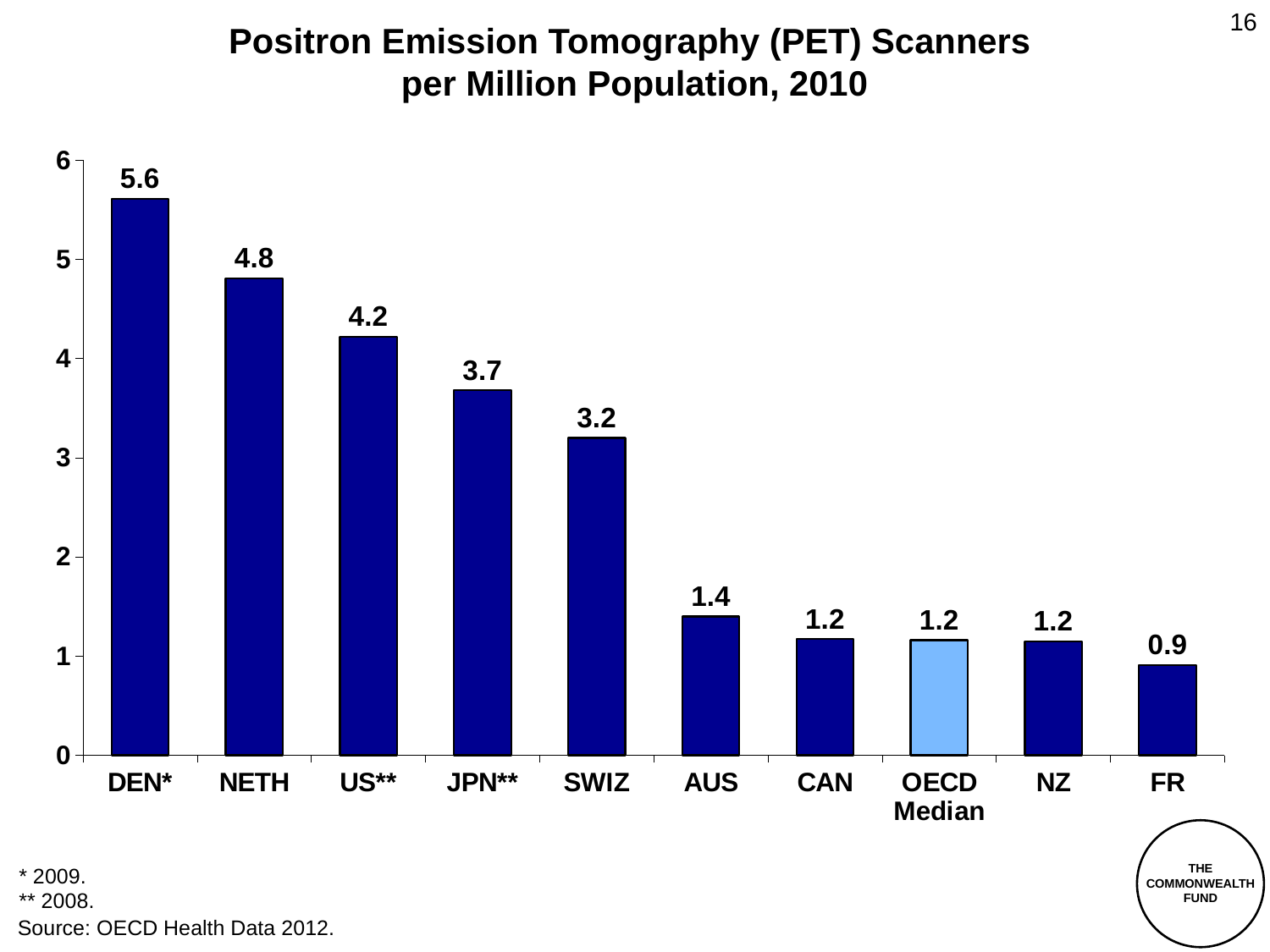
What is the difference between the values for NETH and US**? 0.6 Which category has the highest value? DEN* Is the value for US** greater or less than 4? greater What is the value for JPN**? 3.7 How many categories are shown on the x axis? 10 Which is larger, the value for SWIZ or the value for AUS? SWIZ Which category has the lowest value? FR What kind of chart is shown on the slide? bar chart What is the value for DEN*? 5.6 What is the difference between the values for DEN* and FR? 4.7 What is the value for the OECD Median? 1.2 Which bar is shown in a lighter blue colour than the others? OECD Median